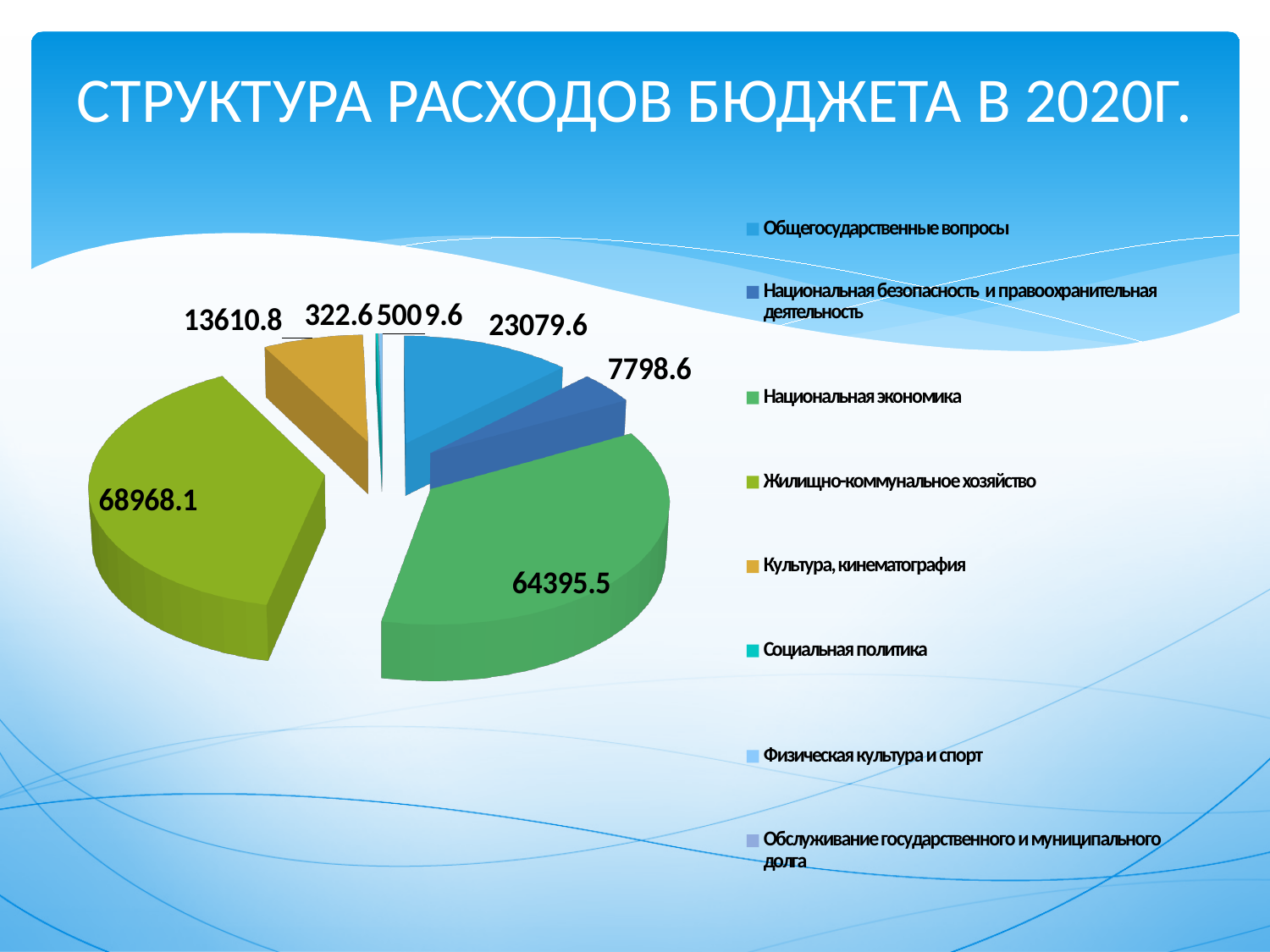
Which category has the smallest slice of the pie? Обслуживание государственного и муниципального долга What is the value for Общегосударственные вопросы? 23079.6 What is the title of the chart on the slide? СТРУКТУРА РАСХОДОВ БЮДЖЕТА В 2020Г. What is the value for Жилищно-коммунальное хозяйство? 68968.1 What is the value for Национальная безопасность и правоохранительная деятельность? 7798.6 What is the difference between the values for Общегосударственные вопросы and Национальная безопасность и правоохранительная деятельность? 15281 What is the value for Культура, кинематография? 13610.8 Which is larger: Национальная экономика or Жилищно-коммунальное хозяйство? Жилищно-коммунальное хозяйство What kind of chart is shown on the slide? Pie chart What is the difference between the values for Жилищно-коммунальное хозяйство and Национальная экономика? 4572.6 How many categories does the legend list? 8 Which category has the largest slice of the pie? Жилищно-коммунальное хозяйство